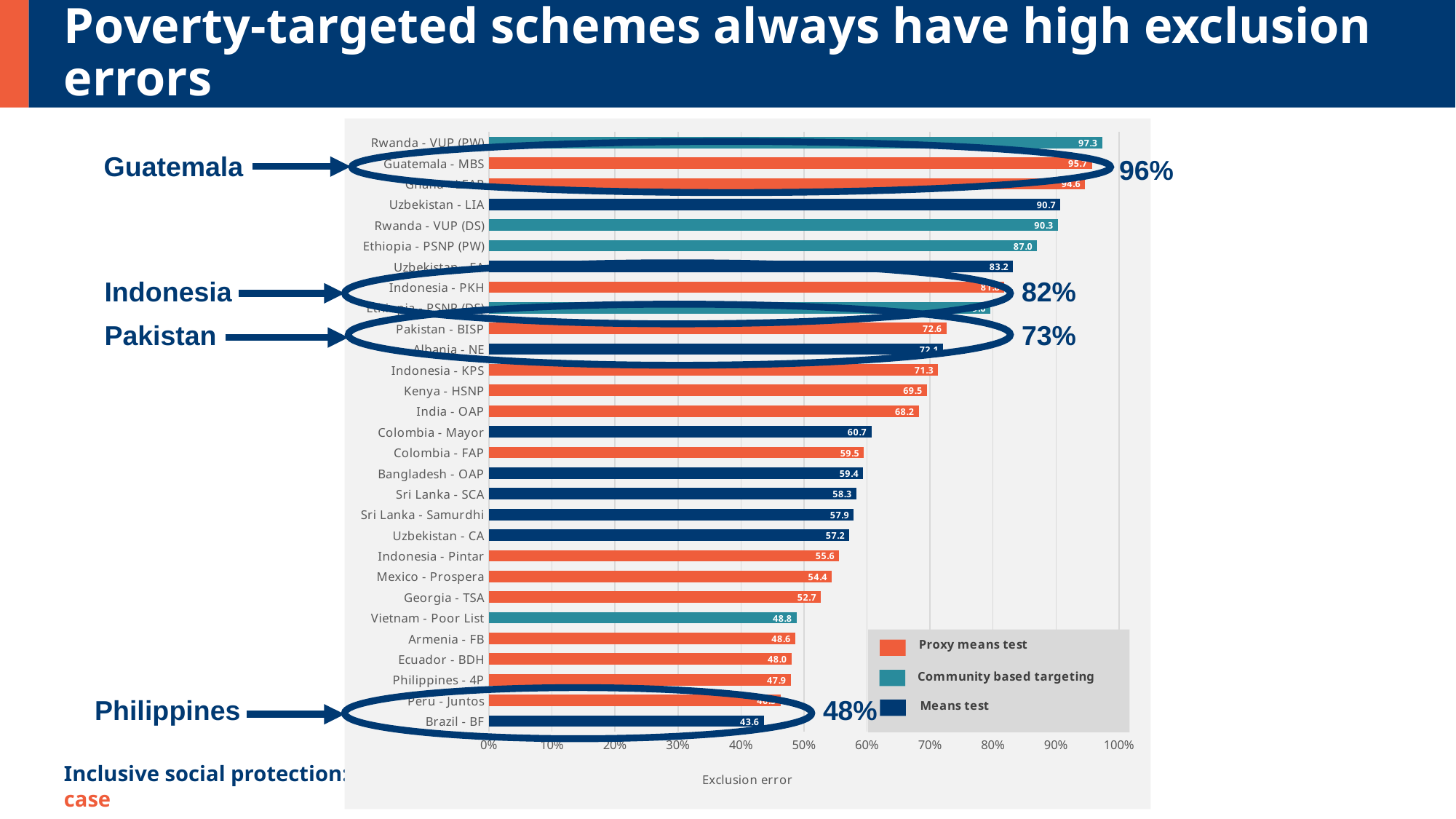
What kind of chart is shown on the slide? bar chart What is the difference between the exclusion error values for Rwanda - VUP (PW) and Rwanda - VUP (DS)? 7.0 What is the difference between the exclusion error values for Colombia - Mayor and Colombia - FAP? 1.2 What is the exclusion error value shown for Brazil - BF? 43.6 What is the exclusion error value shown for Uzbekistan - LIA? 90.7 Which has a higher exclusion error, Kenya - HSNP or India - OAP? Kenya - HSNP What is the exclusion error value shown for Mexico - Prospera? 54.4 What is the exclusion error value shown for Rwanda - VUP (PW)? 97.3 Is the exclusion error for Georgia - TSA greater or less than 50%? greater How many series does the legend list? 3 Which scheme has the highest exclusion error in the chart? Rwanda - VUP (PW) Which scheme has the lowest exclusion error in the chart? Brazil - BF